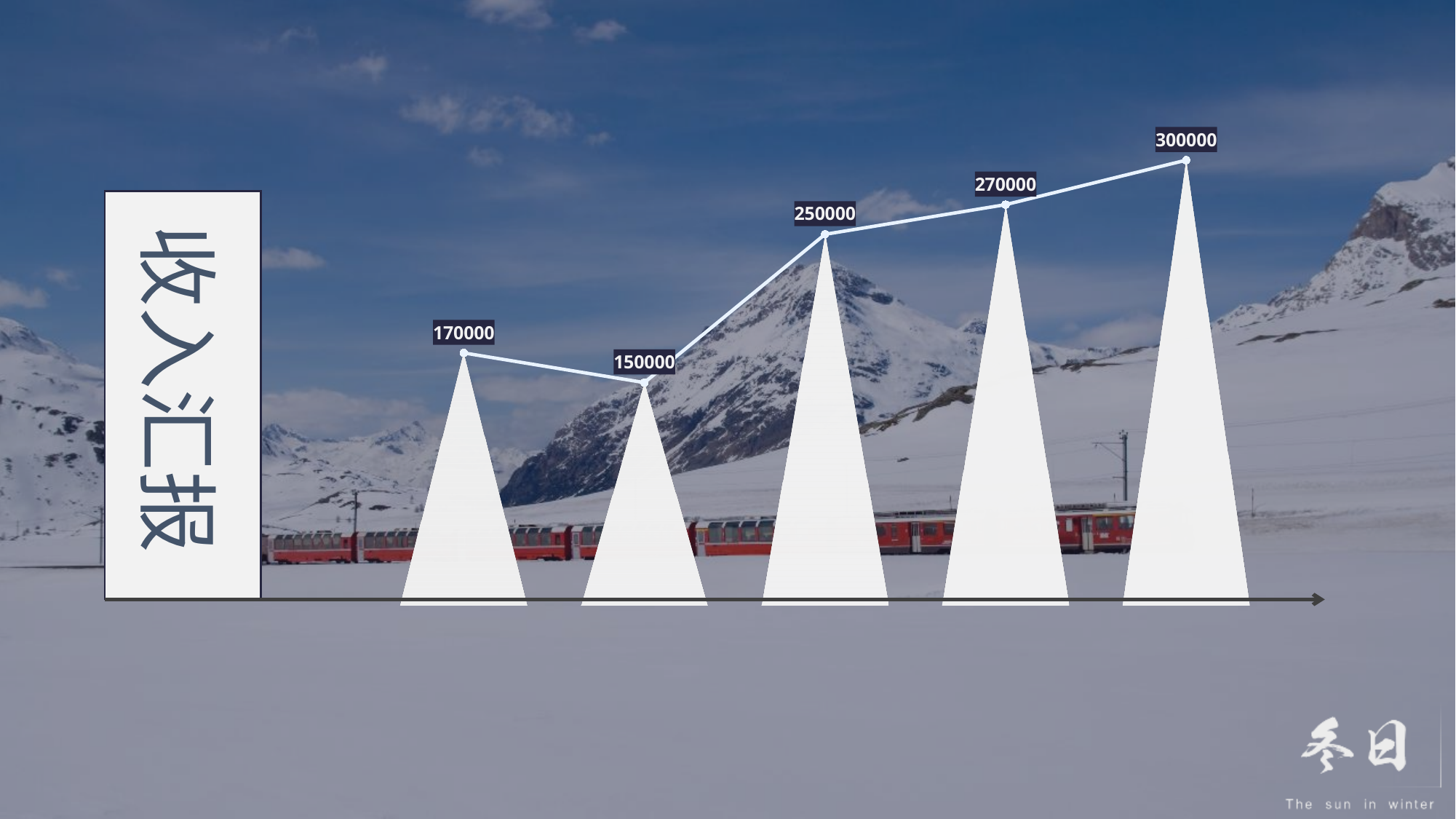
What is the value of the last (rightmost) point on the chart? 300000 What is the difference between the rightmost value and the leftmost value on the chart? 130000 What is the value of the first (leftmost) point on the chart? 170000 How many data points are plotted on the chart? 5 Which is larger, the first value or the second value on the chart? the first value (170000) What is the value of the third point on the chart? 250000 What is the lowest value shown on the chart? 150000 What is the highest value shown on the chart? 300000 What is the title shown next to the chart? 收入汇报 What is the value of the fourth point on the chart? 270000 What is the value of the second point from the left on the chart? 150000 What is the difference between the third and fourth values on the chart? 20000